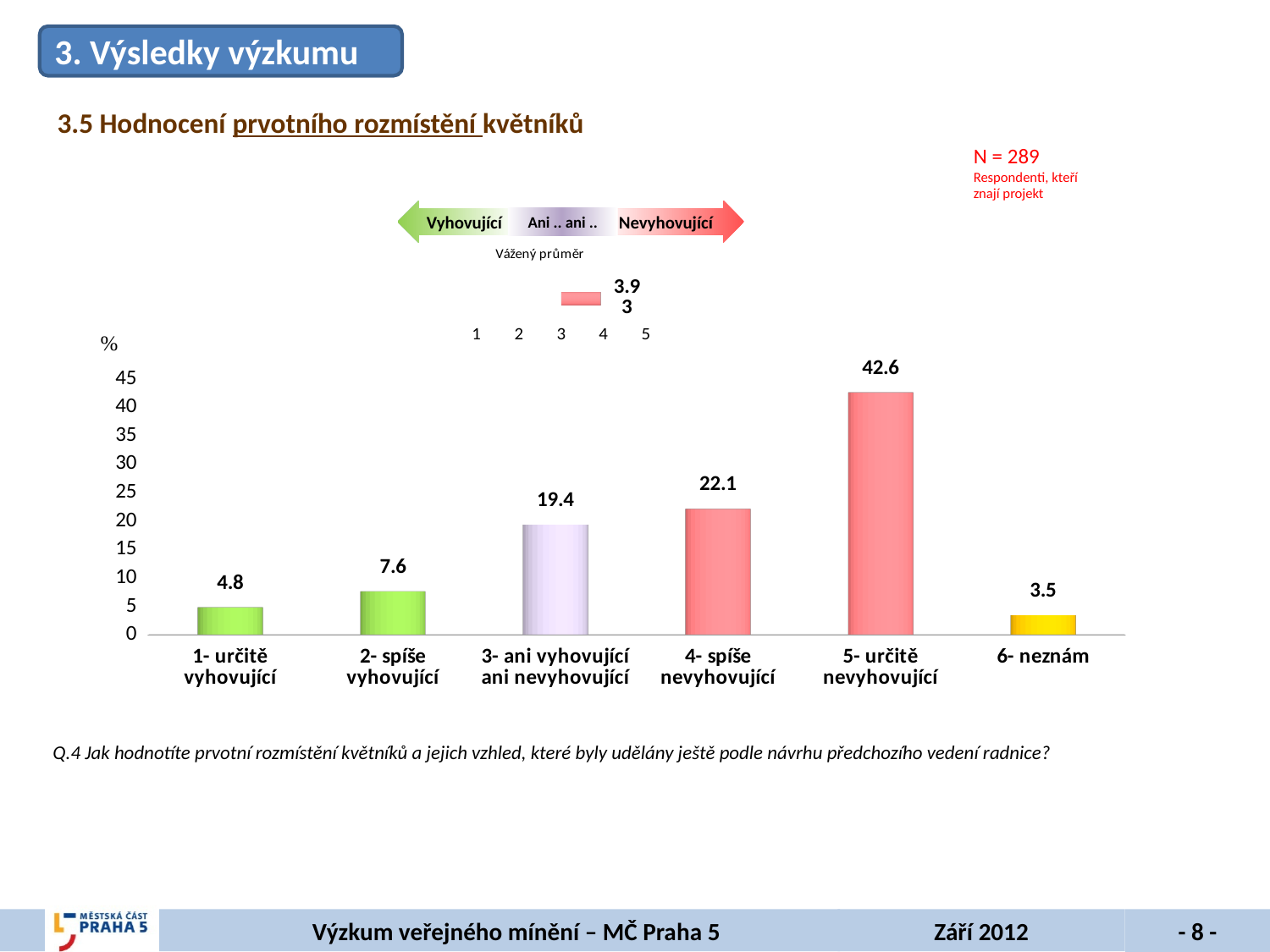
In the main bar chart, what is the value for "3- ani vyhovující ani nevyhovující"? 19.4 In the main bar chart, what is the value for "6- neznám"? 3.5 In the main bar chart, which category has the lowest value? 6- neznám In the main bar chart, what is the value for "1- určitě vyhovující"? 4.8 In the main bar chart, is the value for "4- spíše nevyhovující" greater or less than 20? greater How many categories are shown in the main bar chart? 6 What kind of chart is the main chart on the slide? bar chart What is the sample size (N) stated on the slide? N = 289 In the main bar chart, which category has the highest value? 5- určitě nevyhovující In the main bar chart, what is the value for "5- určitě nevyhovující"? 42.6 In the main bar chart, which is larger: the value for "2- spíše vyhovující" or the value for "3- ani vyhovující ani nevyhovující"? 3- ani vyhovující ani nevyhovující In the main bar chart, what is the difference between the values for "5- určitě nevyhovující" and "4- spíše nevyhovující"? 20.5